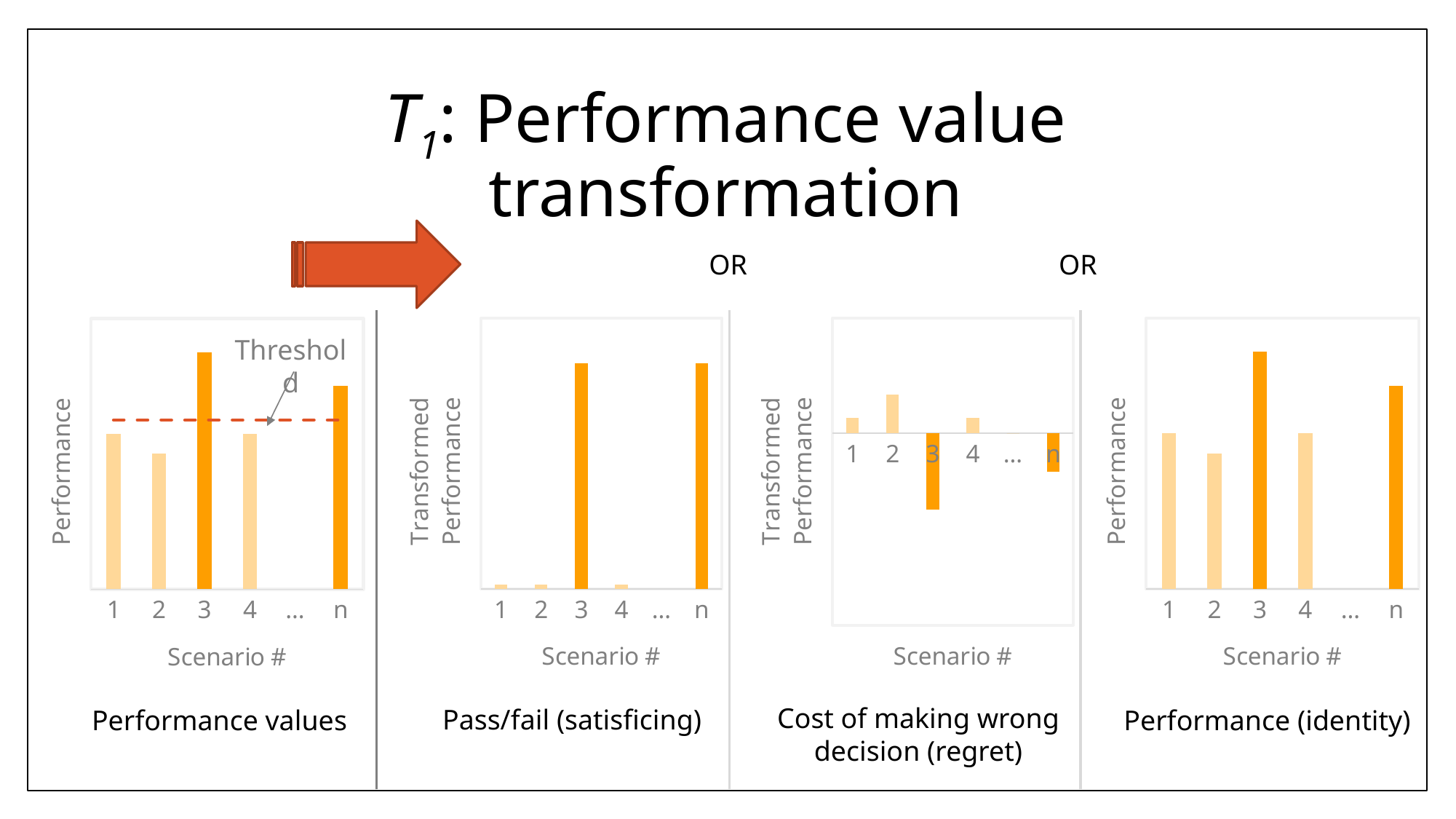
In the 'Performance values' chart, which is larger, the bar for scenario 3 or the bar for scenario n? scenario 3 What kind of chart is the 'Performance values' chart on the left of the slide? bar chart In the 'Pass/fail (satisficing)' chart, which is larger, the bar for scenario 3 or the bar for scenario 1? scenario 3 In the 'Performance values' chart, which scenario has the lowest bar? 2 In the 'Cost of making wrong decision (regret)' chart, which scenario has the lowest (most negative) bar? 3 In the 'Performance (identity)' chart on the right, which is larger, the bar for scenario n or the bar for scenario 2? scenario n How many bars are plotted in the 'Performance values' chart? 5 What is the x-axis label of the 'Performance values' chart? Scenario # In the 'Performance values' chart, which scenario has the highest bar? 3 In the 'Cost of making wrong decision (regret)' chart, which scenario has the highest bar? 2 In the 'Performance (identity)' chart on the right, which scenario has the highest bar? 3 What does the dashed line in the 'Performance values' chart represent, according to its label? Threshold